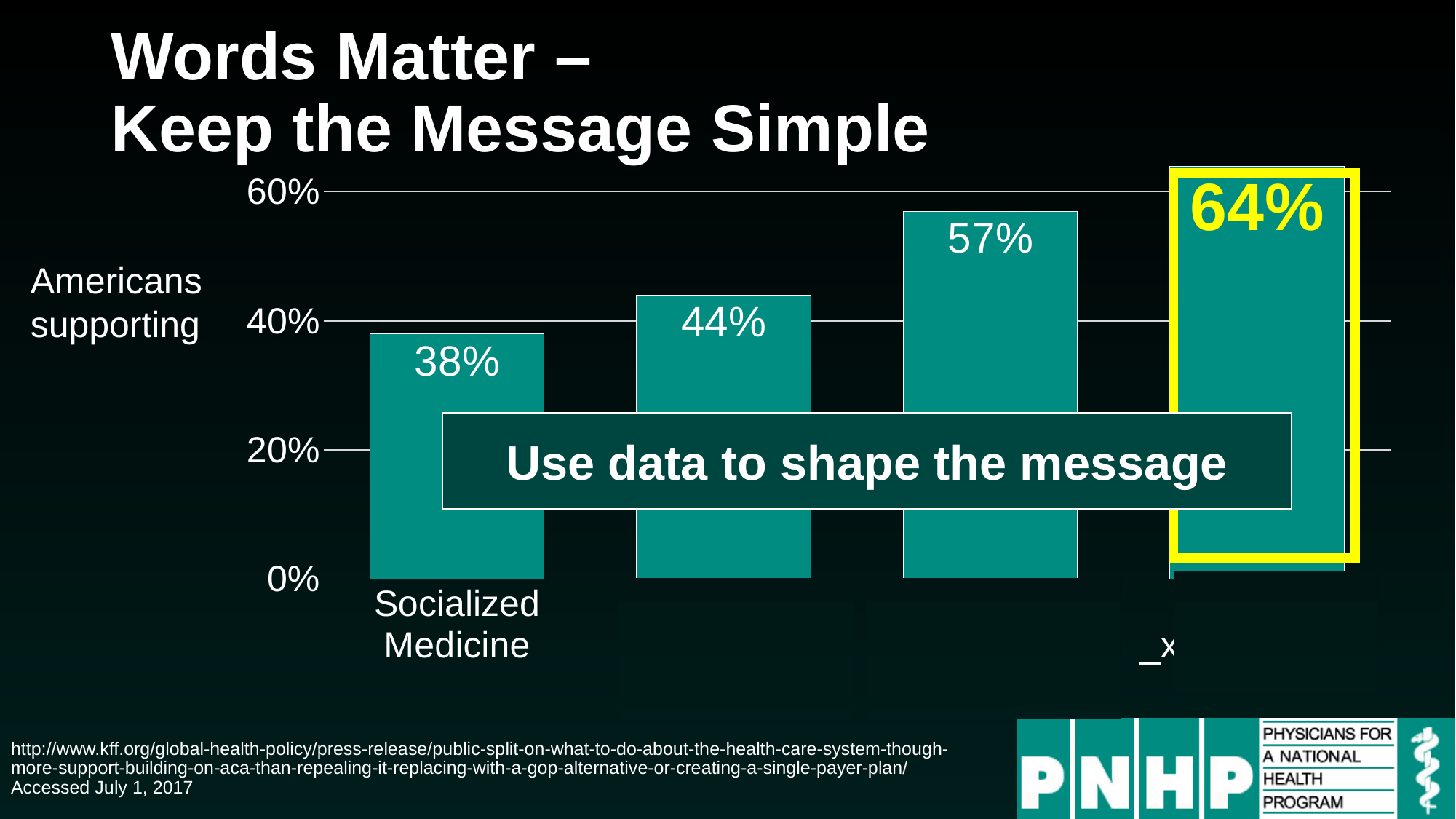
What is the difference between the highest bar (64%) and the "Socialized Medicine" bar (38%)? 26% What value is shown on the rightmost bar, highlighted in yellow? 64% Is the value for "Socialized Medicine" greater or less than 40%? less What type of chart is shown on the slide? Bar chart Which bar has the highest value? The rightmost bar (64%) What value is shown on the third bar from the left? 57% Do the bar values rise or fall from left to right? Rise What value is shown on the second bar from the left? 44% How many bars are plotted in the chart? 4 Which is larger, the second bar (44%) or the third bar (57%)? The third bar (57%) Which labeled category has the lowest value? Socialized Medicine What percentage of Americans support "Socialized Medicine" according to the chart? 38%